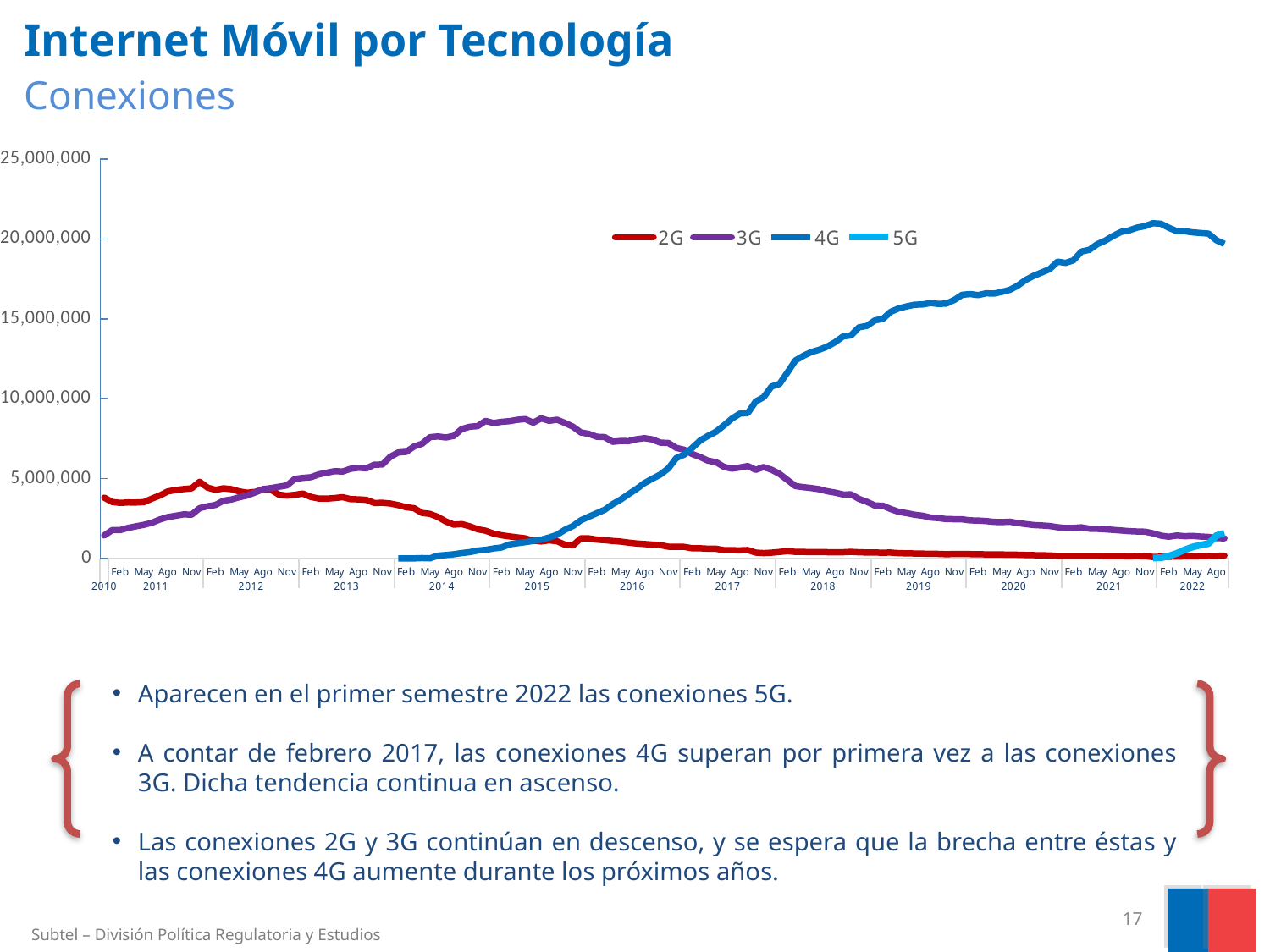
Is the peak value of the 3G line (around 2015) greater or less than 10,000,000? less Which technologies are listed in the chart legend? 2G, 3G, 4G, 5G Which series has the lowest number of connections at the end of the chart (Ago 2022)? 2G What kind of chart is shown on the slide? Line chart Which series has the highest number of connections at the end of the chart (Ago 2022)? 4G Is the peak value of the 3G line (around 2015) greater or less than 5,000,000? greater Does the 4G line rise or fall between 2014 and 2021? Rises Does the 2G line rise or fall between 2012 and 2022? Falls How many series does the chart legend list? 4 Is the peak value of the 4G line greater or less than 20,000,000? greater What colour is the 4G line in the chart? Blue In 2013, which series has more connections, 2G or 3G? 3G